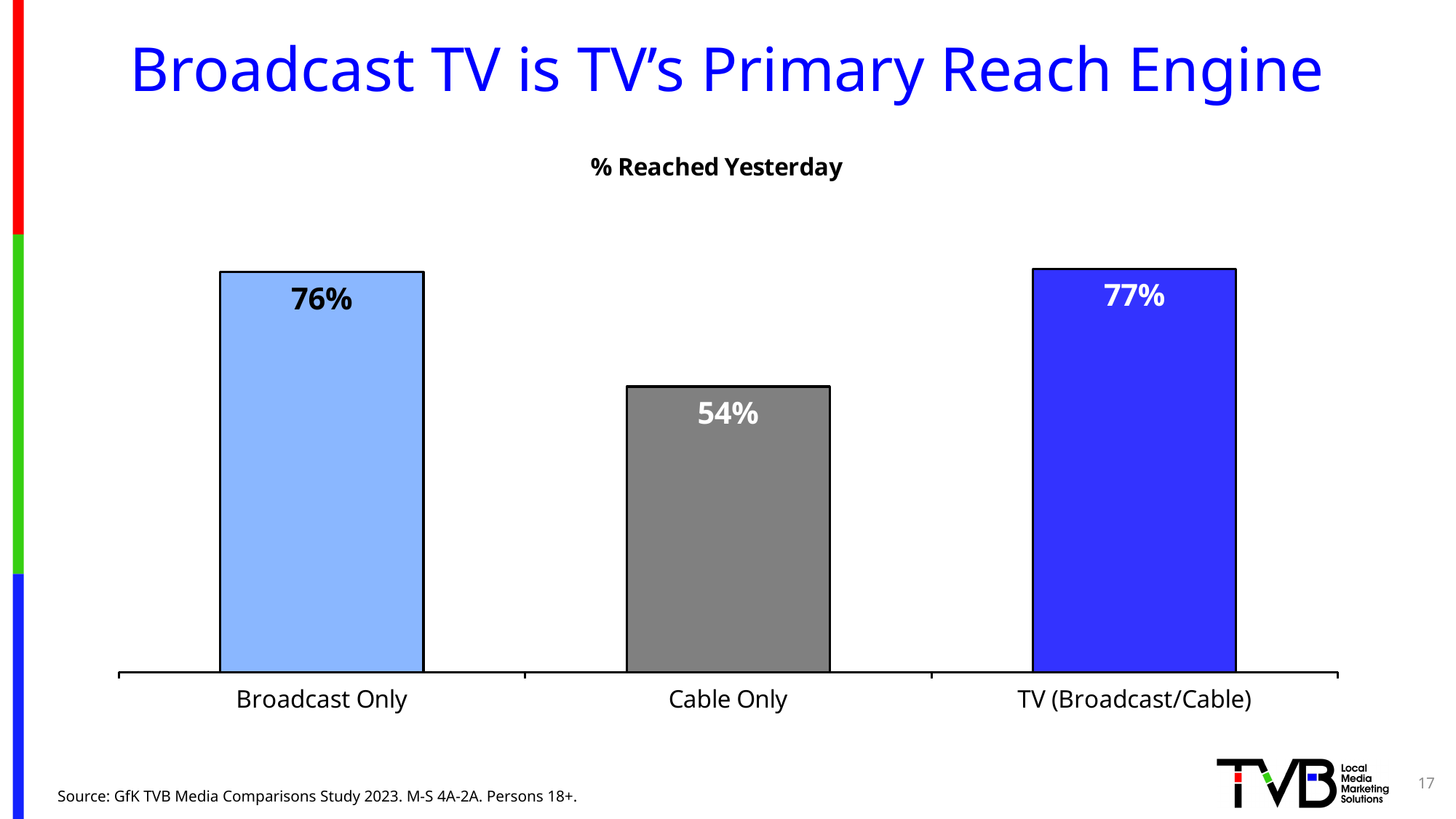
What is the value for TV (Broadcast/Cable)? 77% Which category has the highest value? TV (Broadcast/Cable) What is the value for Broadcast Only? 76% What colour is the bar for Cable Only? Gray What is the difference between the values for TV (Broadcast/Cable) and Cable Only? 23% How many categories are shown in the chart? 3 Which category has the lowest value? Cable Only What kind of chart is shown on the slide? Bar chart What is the value for Cable Only? 54% What is the difference between the values for Broadcast Only and Cable Only? 22% Which is larger, the value for Broadcast Only or the value for Cable Only? Broadcast Only What is the title of the chart? % Reached Yesterday